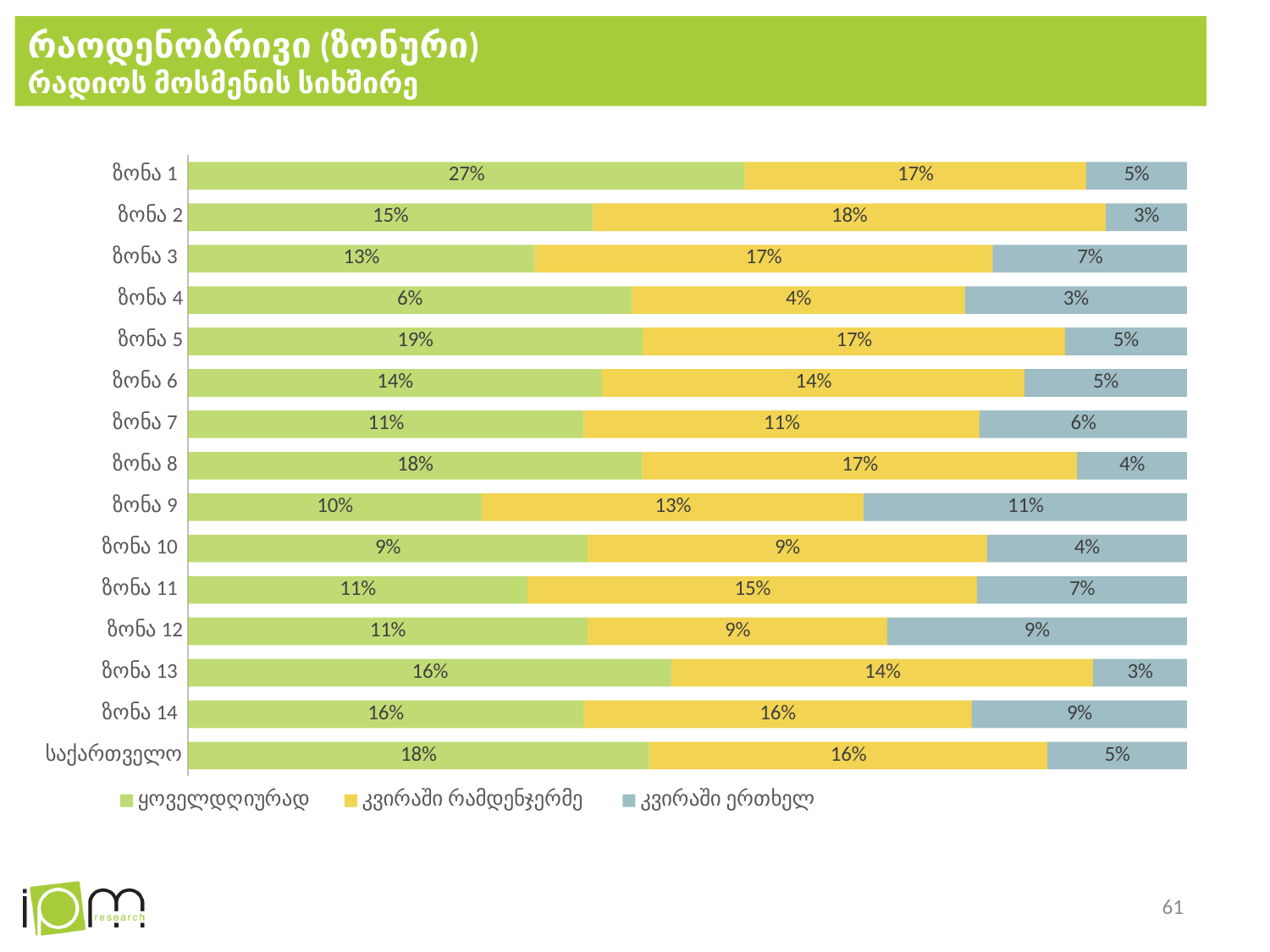
What is the value of კვირაში რამდენჯერმე for საქართველო? 16% How many series does the legend list? 3 What is the total of the three labelled segments for ზონა 1? 49% Which is larger: the კვირაში რამდენჯერმე value for ზონა 2 or for ზონა 4? ზონა 2 What is the value of ყოველდღიურად for ზონა 1? 27% What is the difference between the ყოველდღიურად values for ზონა 1 and ზონა 2? 12% Which category has the highest value for ყოველდღიურად? ზონა 1 What is the value of კვირაში ერთხელ for ზონა 9? 11% Which category has the highest value for კვირაში ერთხელ? ზონა 9 How many categories (bars) are plotted in the chart? 15 What type of chart is shown on the slide? Stacked bar chart Which category has the lowest value for ყოველდღიურად? ზონა 4